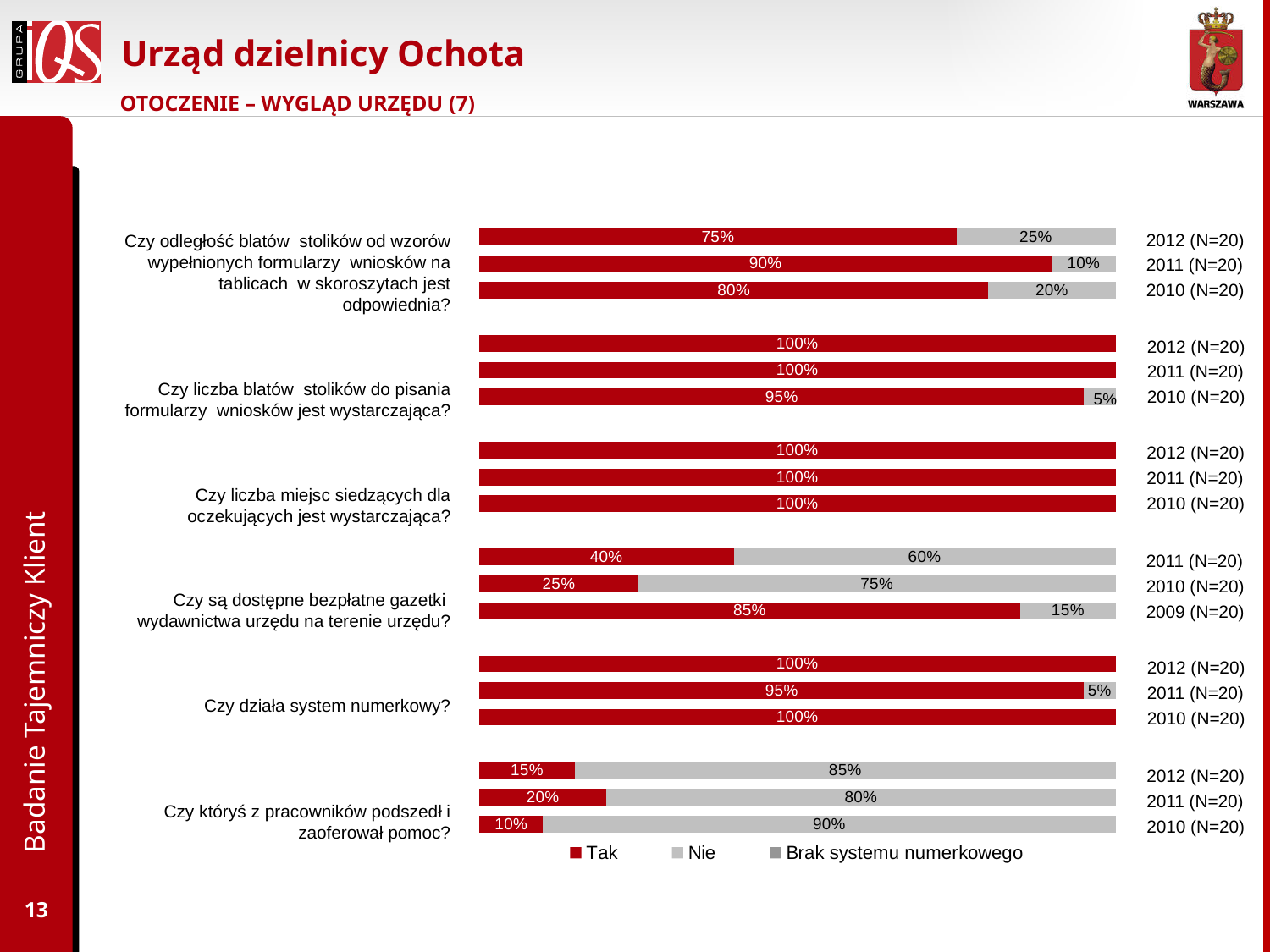
What is the 'Nie' value for 2011 for the question 'Czy są dostępne bezpłatne gazetki wydawnictwa urzędu na terenie urzędu?' 60% What kind of chart is shown on the slide? stacked bar chart For the question 'Czy są dostępne bezpłatne gazetki wydawnictwa urzędu na terenie urzędu?', which year has the highest 'Tak' value? 2009 For the question 'Czy któryś z pracowników podszedł i zaoferował pomoc?', which year has the lowest 'Tak' value? 2010 How many years are shown for the question 'Czy liczba miejsc siedzących dla oczekujących jest wystarczająca?' 3 How many series does the legend list? 3 What is the 'Tak' value for 2012 for the question 'Czy odległość blatów stolików od wzorów wypełnionych formularzy wniosków na tablicach w skoroszytach jest odpowiednia?' 75% What is the sample size (N) shown for each bar on the chart? N=20 What is the 'Tak' value for 2010 for the question 'Czy liczba blatów stolików do pisania formularzy wniosków jest wystarczająca?' 95% What is the difference between the 'Tak' values for 2011 and 2012 for the question 'Czy odległość blatów stolików od wzorów wypełnionych formularzy wniosków na tablicach w skoroszytach jest odpowiednia?' 15% For the question 'Czy działa system numerkowy?', is the 'Tak' value for 2011 larger or smaller than for 2012? smaller What is the 'Nie' value for 2011 for the question 'Czy odległość blatów stolików od wzorów wypełnionych formularzy wniosków na tablicach w skoroszytach jest odpowiednia?' 10%